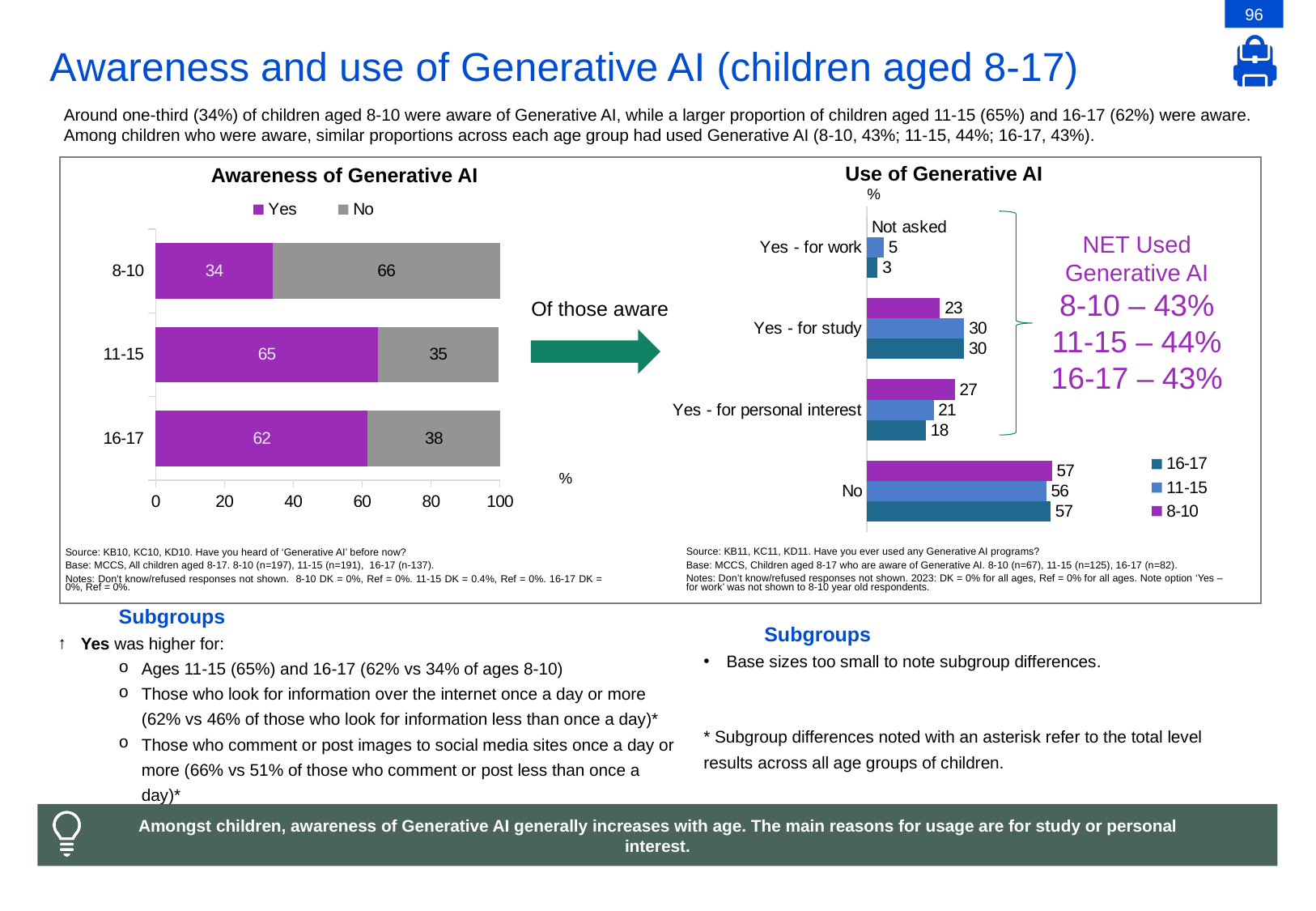
In the Awareness of Generative AI chart, what is the difference between the Yes values for ages 11-15 and ages 8-10? 31 In the Use of Generative AI chart, what is the value for 'Yes - for personal interest' among children aged 16-17? 18 In the Awareness of Generative AI chart, what is the No value for children aged 16-17? 38 In the Use of Generative AI chart, how many series does the legend list? 3 In the Awareness of Generative AI chart, what is the total of the stacked bar for ages 11-15? 100 In the Awareness of Generative AI chart, how many series does the legend list? 2 In the Use of Generative AI chart, is the 'No' value for ages 11-15 larger or smaller than the 'Yes - for study' value for ages 11-15? larger In the Use of Generative AI chart, what is the value for 'Yes - for study' among children aged 8-10? 23 In the Awareness of Generative AI chart, which age group has the highest Yes value? 11-15 In the Awareness of Generative AI chart, what is the Yes value for children aged 8-10? 34 What type of chart is the Use of Generative AI chart? Bar chart In the Use of Generative AI chart, which age group has the lowest value for 'Yes - for work'? 16-17